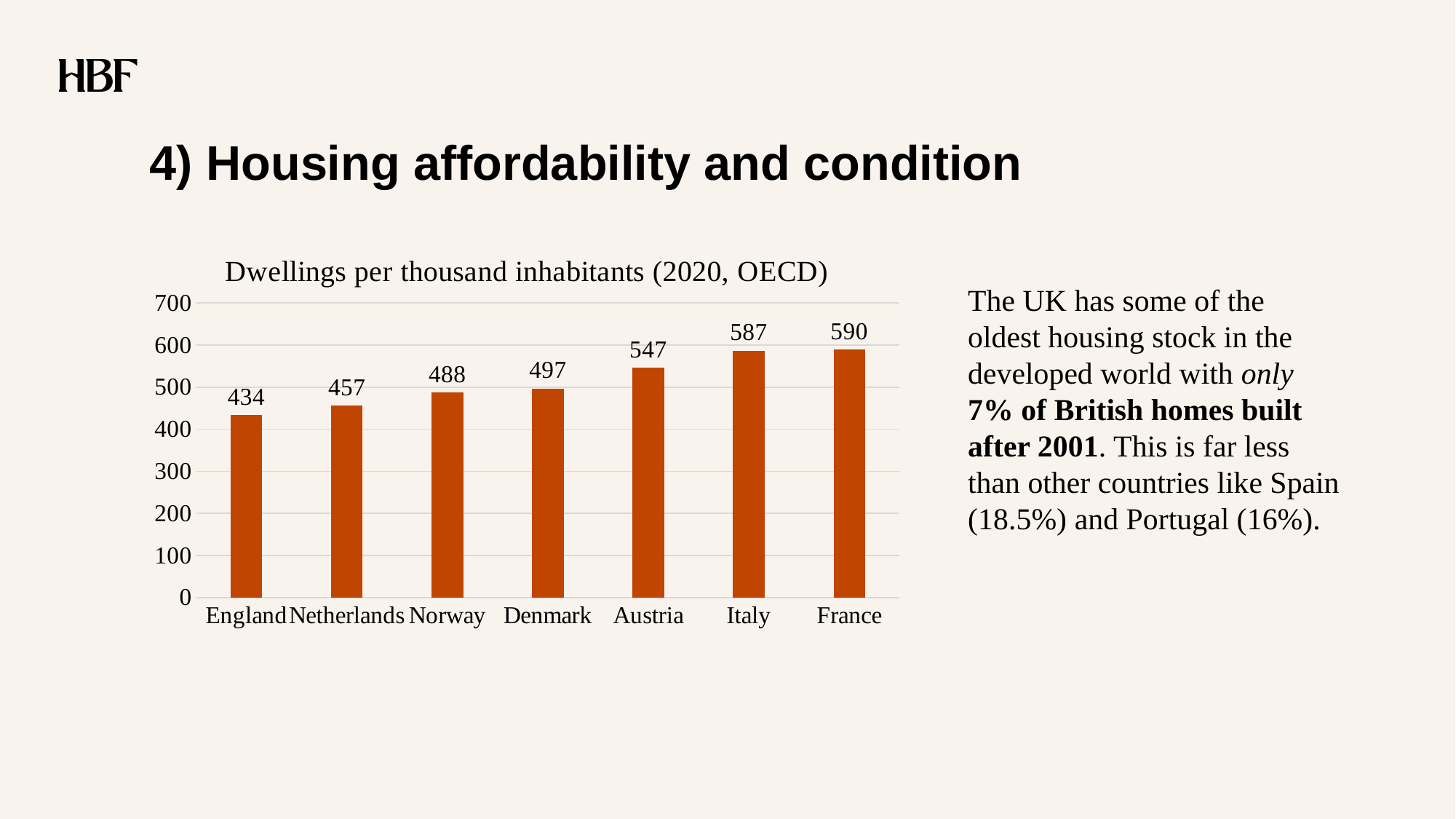
What is the value for England in the chart? 434 What is the value for Denmark in the chart? 497 Which country has the highest number of dwellings per thousand inhabitants? France What is the difference between the values for Norway and Netherlands? 31 How many countries are shown in the chart? 7 What is the value for Austria in the chart? 547 Is the value for Norway greater or less than 500? less What is the title of the chart? Dwellings per thousand inhabitants (2020, OECD) Which has a higher value, Austria or Denmark? Austria What kind of chart is shown on the slide? Bar chart What is the difference between the values for France and England? 156 Which country has the lowest number of dwellings per thousand inhabitants? England